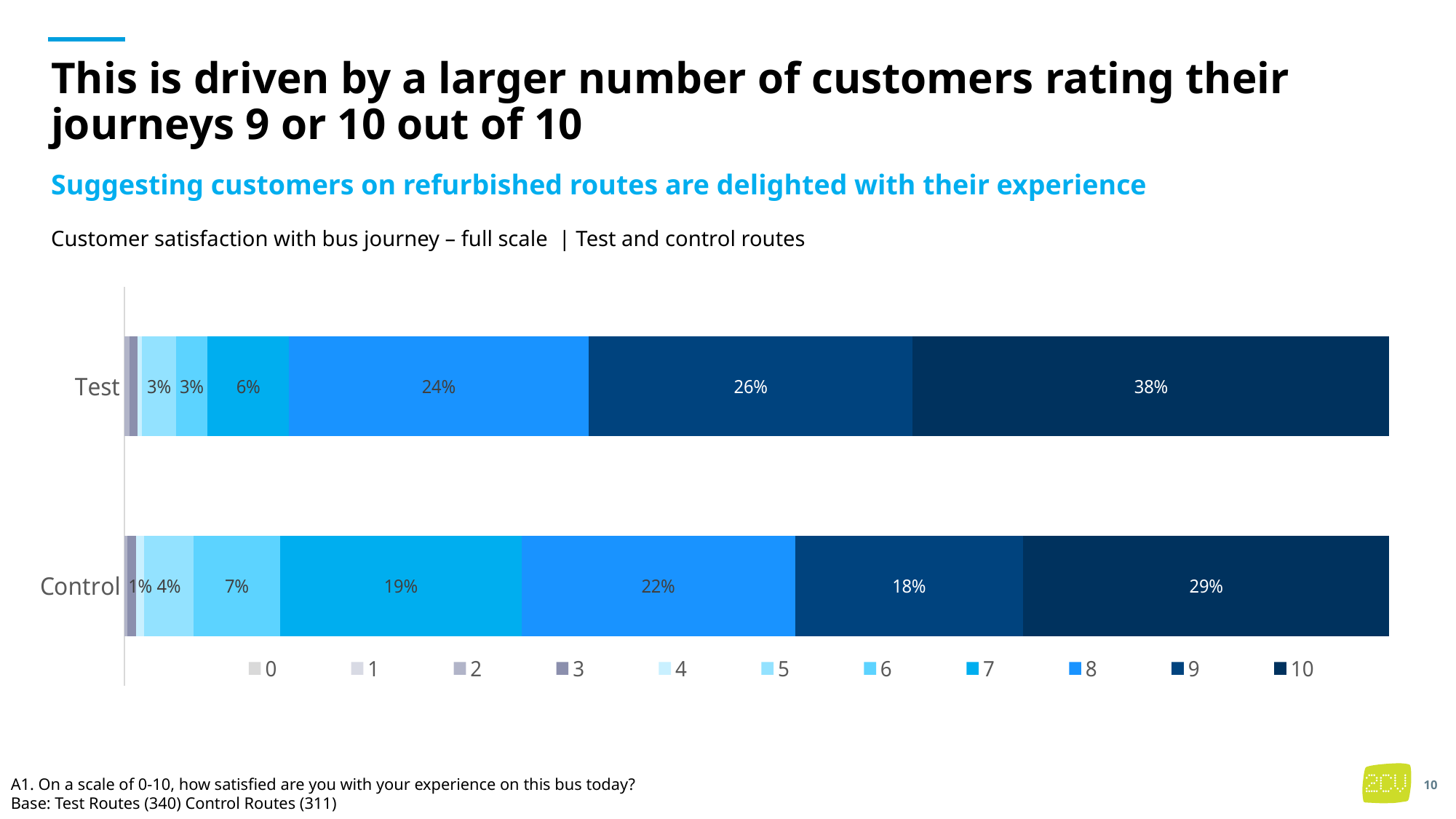
How many rating categories does the legend list? 11 Which route group has the larger share of customers rating their journey 9: Test or Control? Test What type of chart is shown on the slide? Stacked bar chart What is the title of the chart? Customer satisfaction with bus journey – full scale | Test and control routes What percentage of Test route customers gave a rating of 9? 26% What is the combined percentage of Test route customers rating their journey 9 or 10? 64% What is the difference in percentage points between Test and Control for a rating of 10? 9 percentage points How many route groups (bars) are shown in the chart? 2 Which rating has the largest share in the Test bar? 10 What percentage of Control route customers gave a rating of 9? 18% What percentage of Test route customers rated their journey 10 out of 10? 38% What percentage of Control route customers rated their journey 10 out of 10? 29%